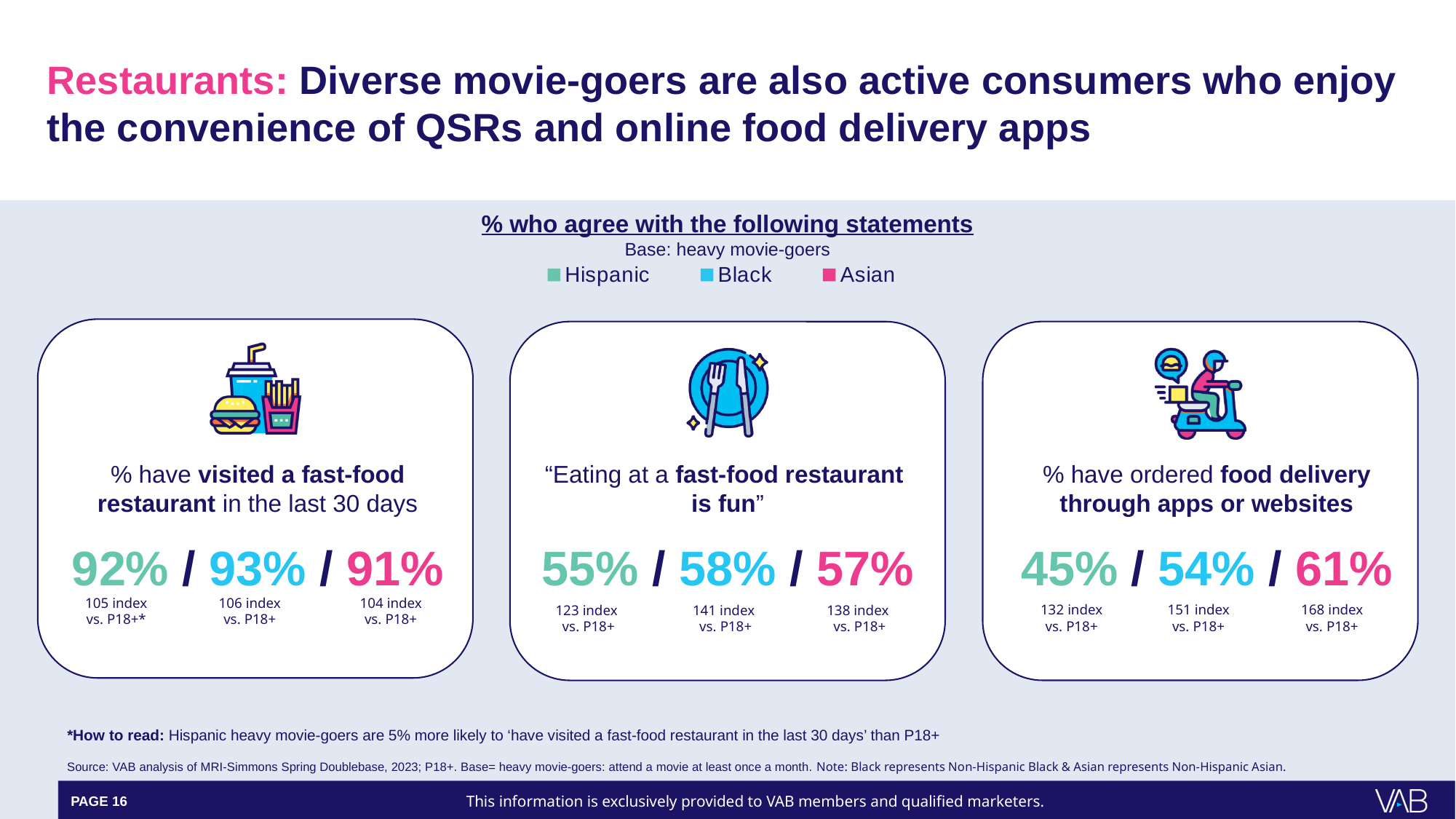
What is the base for the percentages shown? Heavy movie-goers What is the difference between the Asian and Hispanic percentages for ordering food delivery through apps or websites? 16% What percentage of Asian heavy movie-goers have ordered food delivery through apps or websites? 61% How many groups does the legend list? 3 Which group has the lowest share agreeing that eating at a fast-food restaurant is fun? Hispanic Which colour represents Asian in the legend? Pink What percentage of Hispanic heavy movie-goers have visited a fast-food restaurant in the last 30 days? 92% How many statements are shown with percentages on the slide? 3 What percentage of Black heavy movie-goers agree that eating at a fast-food restaurant is fun? 58% Which group has the highest share that has ordered food delivery through apps or websites? Asian What is the index vs. P18+ for Black heavy movie-goers who have ordered food delivery through apps or websites? 151 index For visiting a fast-food restaurant in the last 30 days, which is larger: the Black or the Asian percentage? Black